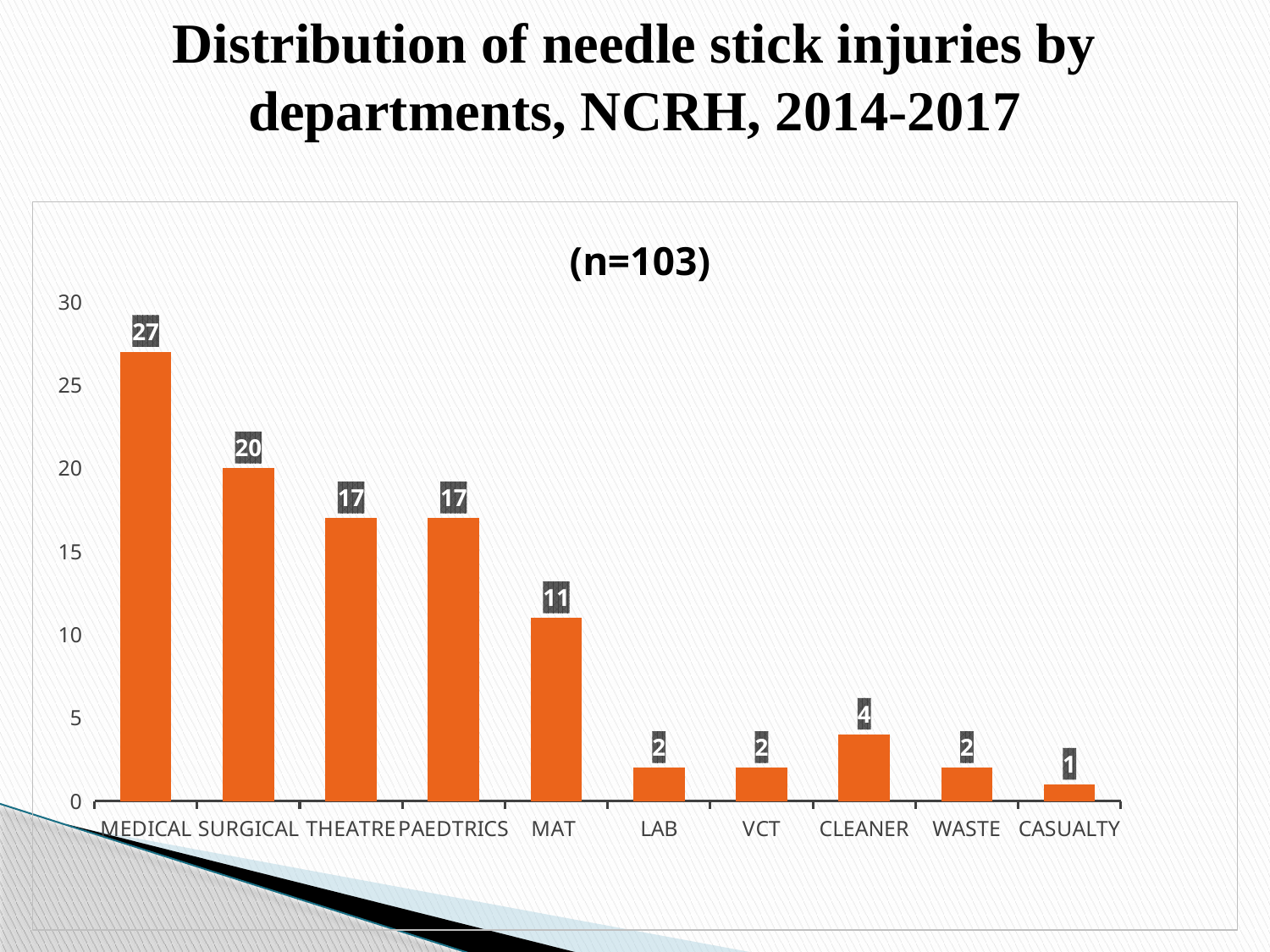
What is the chart's internal title shown above the plot area? (n=103) Is the value for MAT greater or less than 10? greater Which is larger, the value for SURGICAL or the value for THEATRE? SURGICAL Which department has the lowest number of needle stick injuries? CASUALTY How many departments are shown on the x axis? 10 What is the difference between the values for MAT and CLEANER? 7 What kind of chart is shown on the slide? Bar chart Which department has the highest number of needle stick injuries? MEDICAL What is the value for MAT? 11 What is the value for MEDICAL? 27 What is the difference between the values for MEDICAL and SURGICAL? 7 What is the value for CLEANER? 4